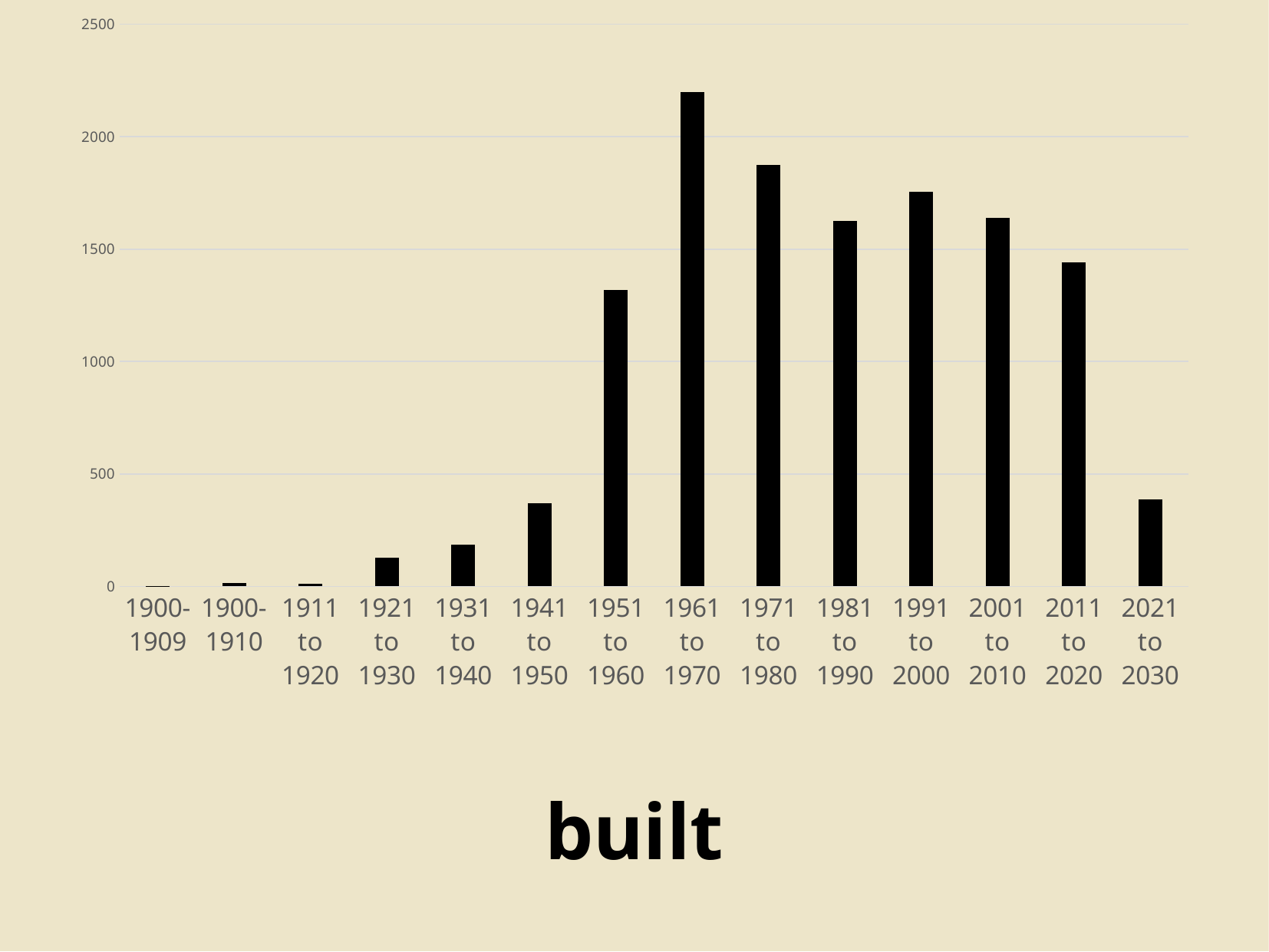
What kind of chart is shown on the slide? bar chart Is the value for 1971 to 1980 greater or less than 2000? less Is the value for 1961 to 1970 greater or less than 2000? greater Is the value for 1991 to 2000 greater or less than 1500? greater Which is larger, the value for 1961 to 1970 or the value for 1971 to 1980? 1961 to 1970 How many categories are plotted on the x axis? 14 Which category has the highest bar? 1961 to 1970 What is the title shown beneath the chart? built Which is larger, the value for 1991 to 2000 or the value for 2011 to 2020? 1991 to 2000 Do the values rise or fall from 1900-1909 through 1961 to 1970? rise